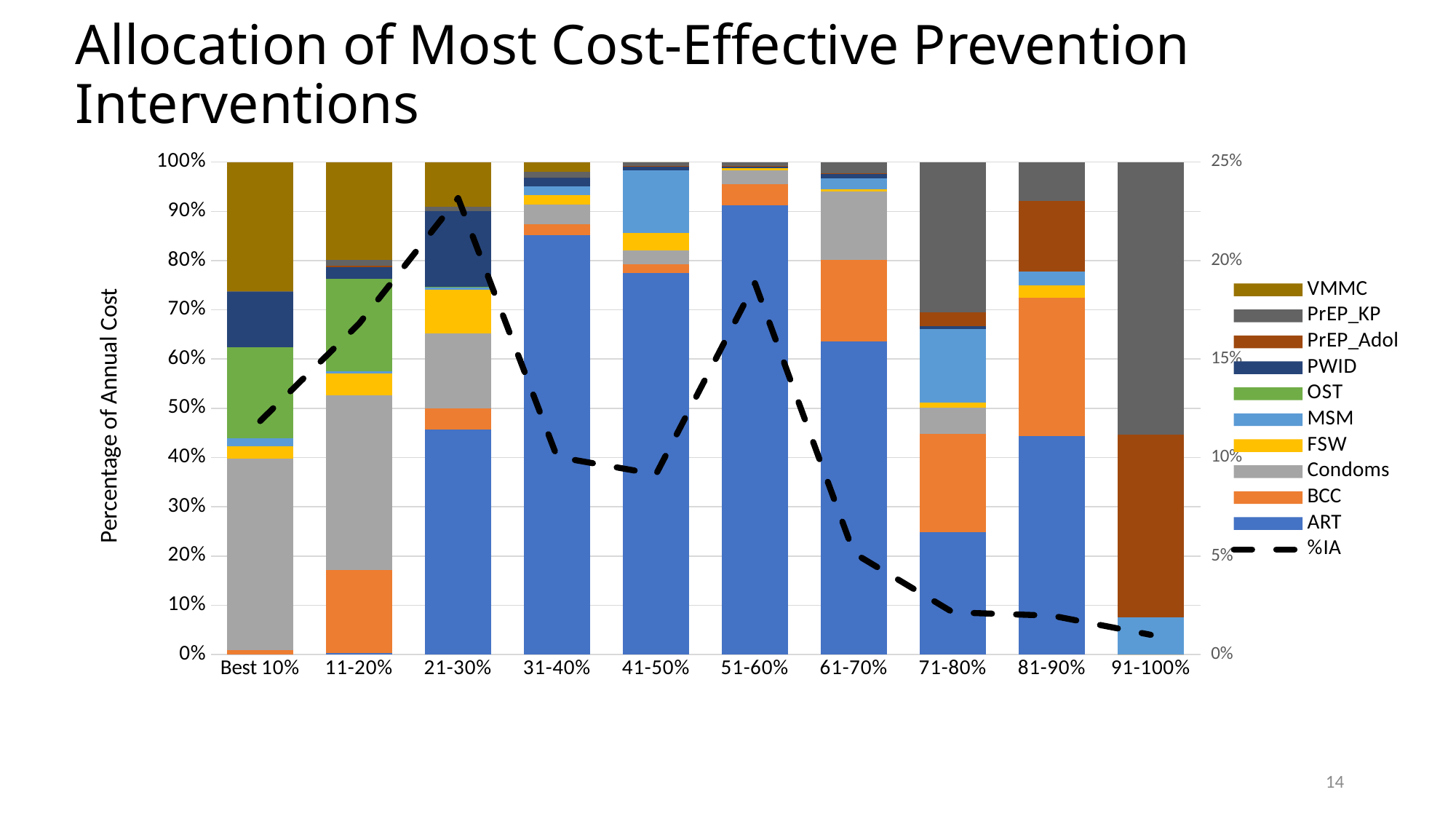
What kind of chart is shown on the slide? Stacked bar chart with a line Which category has the largest ART share? 51-60% Is the ART share for the 71-80% category greater or less than 30%? less Is the %IA value for the 21-30% category greater or less than 20%? greater What is the label of the left vertical axis? Percentage of Annual Cost Which category has the highest %IA value on the dashed line? 21-30% Is the PrEP_KP share for the 91-100% category greater or less than 50%? greater Which has a larger ART share, the 51-60% category or the 71-80% category? 51-60% What is the title of the chart on the slide? Allocation of Most Cost-Effective Prevention Interventions How many categories are shown along the x axis? 10 How many series does the legend list? 11